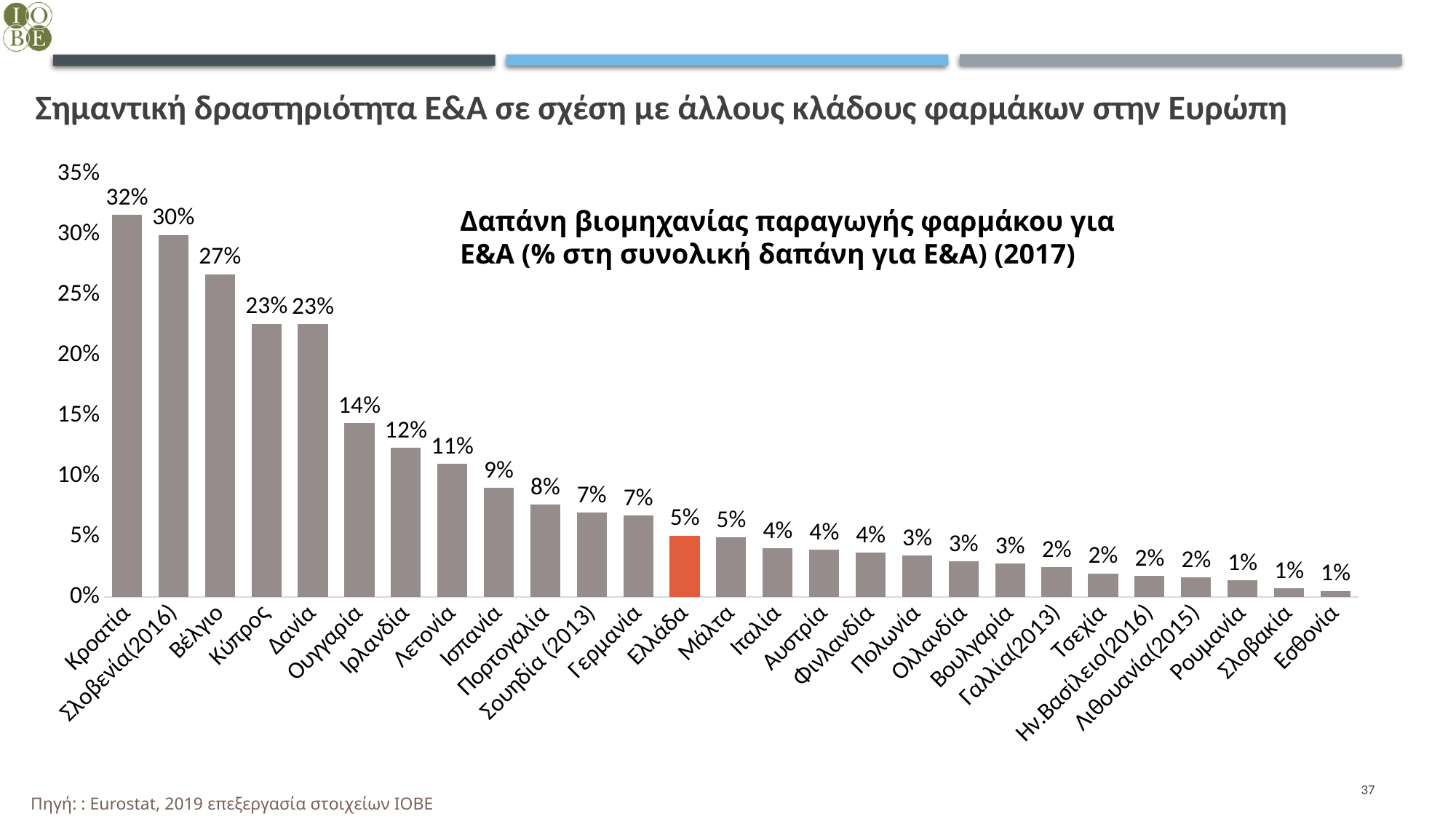
How many countries are shown in the chart? 27 Which country has the highest value? Κροατία What is the value for Ουγγαρία? 14% What is the value for Κροατία? 32% Which bar is highlighted in a different colour (orange) from the others? Ελλάδα Is the value for Σλοβενία(2016) greater or less than 25%? greater What is the difference between the values for Ελλάδα and Ιρλανδία? 7% What kind of chart is shown on the slide? Bar chart What is the difference between the values for Κροατία and Βέλγιο? 5% What is the value for Γερμανία? 7% Which is larger, the value for Λετονία or the value for Ισπανία? Λετονία What is the value for Ελλάδα? 5%